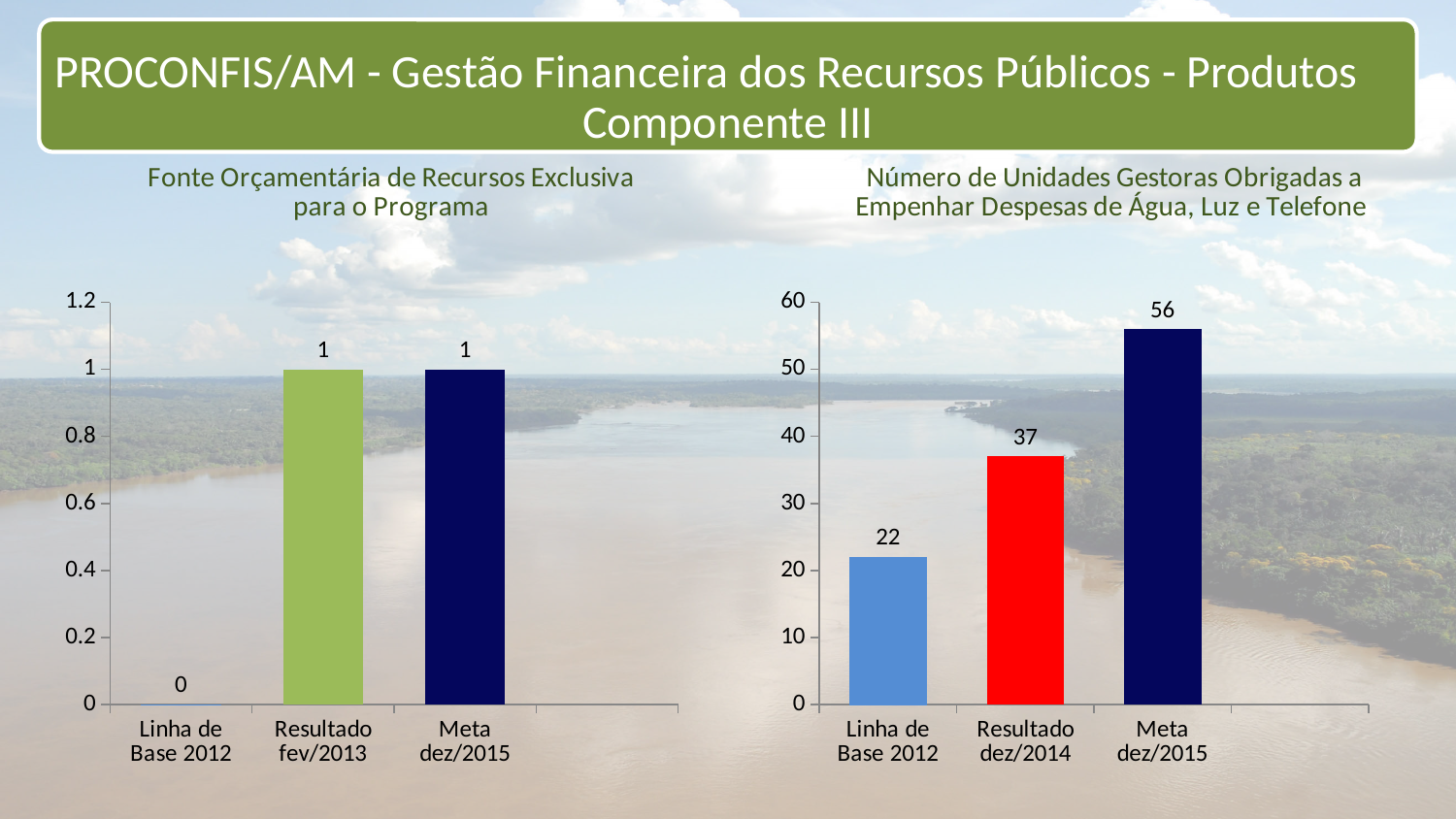
In the chart 'Fonte Orçamentária de Recursos Exclusiva para o Programa', what is the value for Linha de Base 2012? 0 In the chart 'Fonte Orçamentária de Recursos Exclusiva para o Programa', what is the value for Resultado fev/2013? 1 In the chart 'Fonte Orçamentária de Recursos Exclusiva para o Programa', how many categories are shown on the x axis? 3 In the chart 'Número de Unidades Gestoras Obrigadas a Empenhar Despesas de Água, Luz e Telefone', what is the value for Meta dez/2015? 56 In the chart 'Número de Unidades Gestoras Obrigadas a Empenhar Despesas de Água, Luz e Telefone', which category has the highest value? Meta dez/2015 In the chart 'Número de Unidades Gestoras Obrigadas a Empenhar Despesas de Água, Luz e Telefone', what is the difference between Meta dez/2015 and Resultado dez/2014? 19 In the chart 'Número de Unidades Gestoras Obrigadas a Empenhar Despesas de Água, Luz e Telefone', which is larger: Resultado dez/2014 or Linha de Base 2012? Resultado dez/2014 In the chart 'Número de Unidades Gestoras Obrigadas a Empenhar Despesas de Água, Luz e Telefone', which category has the lowest value? Linha de Base 2012 In the chart 'Número de Unidades Gestoras Obrigadas a Empenhar Despesas de Água, Luz e Telefone', do the values rise or fall from left to right along the x axis? Rise In the chart 'Número de Unidades Gestoras Obrigadas a Empenhar Despesas de Água, Luz e Telefone', what is the value for Linha de Base 2012? 22 What type of chart is the chart on the right of the slide? Bar chart In the chart 'Número de Unidades Gestoras Obrigadas a Empenhar Despesas de Água, Luz e Telefone', what is the difference between Resultado dez/2014 and Linha de Base 2012? 15